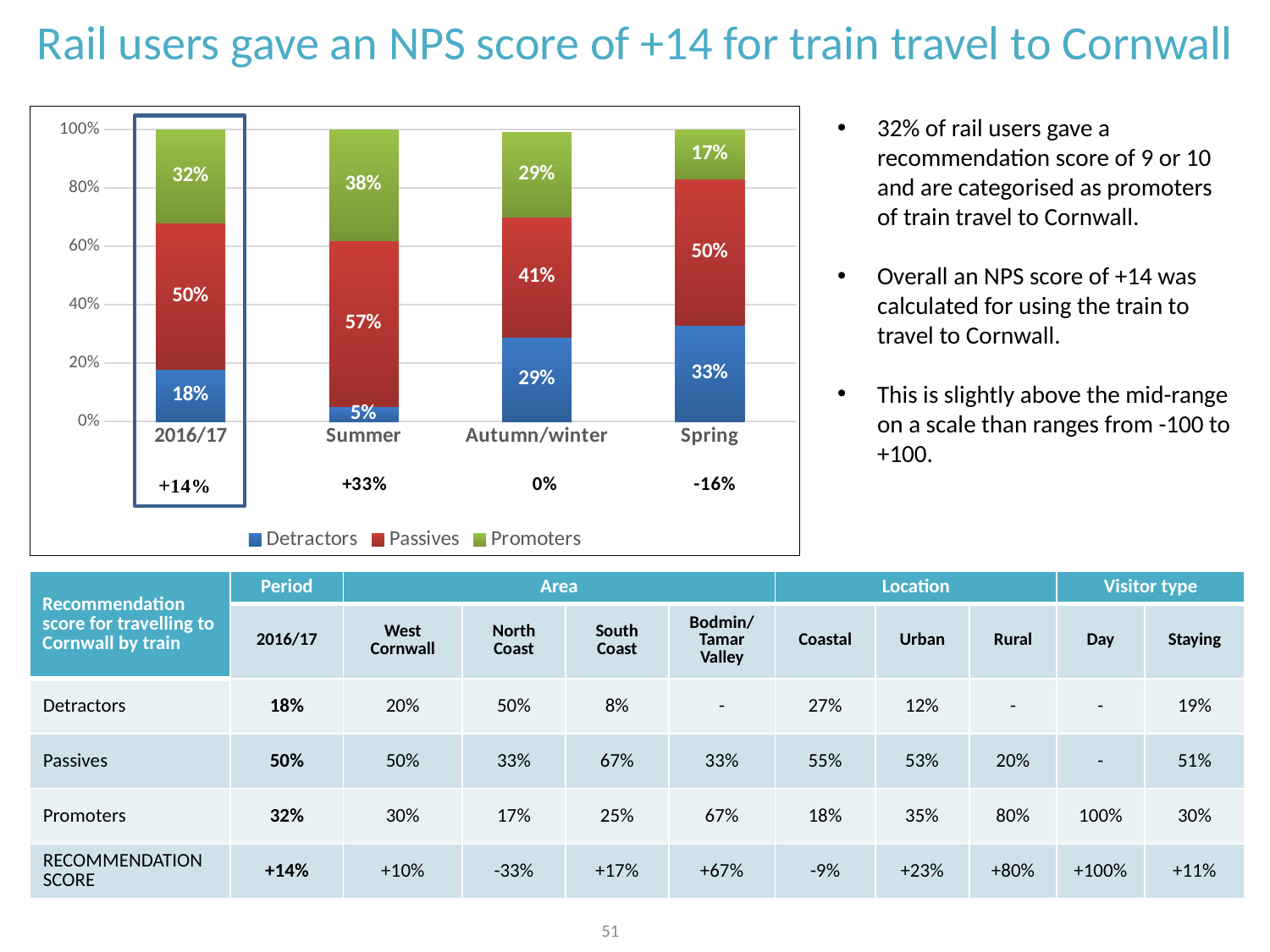
What is the Detractors value for Spring? 33% What is the Passives value for Autumn/winter? 41% Which period has the highest Passives share? Summer What is the difference between the Promoters share in Summer and in Spring? 21% Which period has the lowest Detractors share? Summer How many series does the legend list? 3 Which period has the lowest Promoters share? Spring How many periods are shown on the x axis? 4 What percentage of rail users were Promoters in Summer? 38% Which series is shown in green in the chart? Promoters Is the Detractors share larger in Spring or in 2016/17? Spring What type of chart is shown? Stacked bar chart